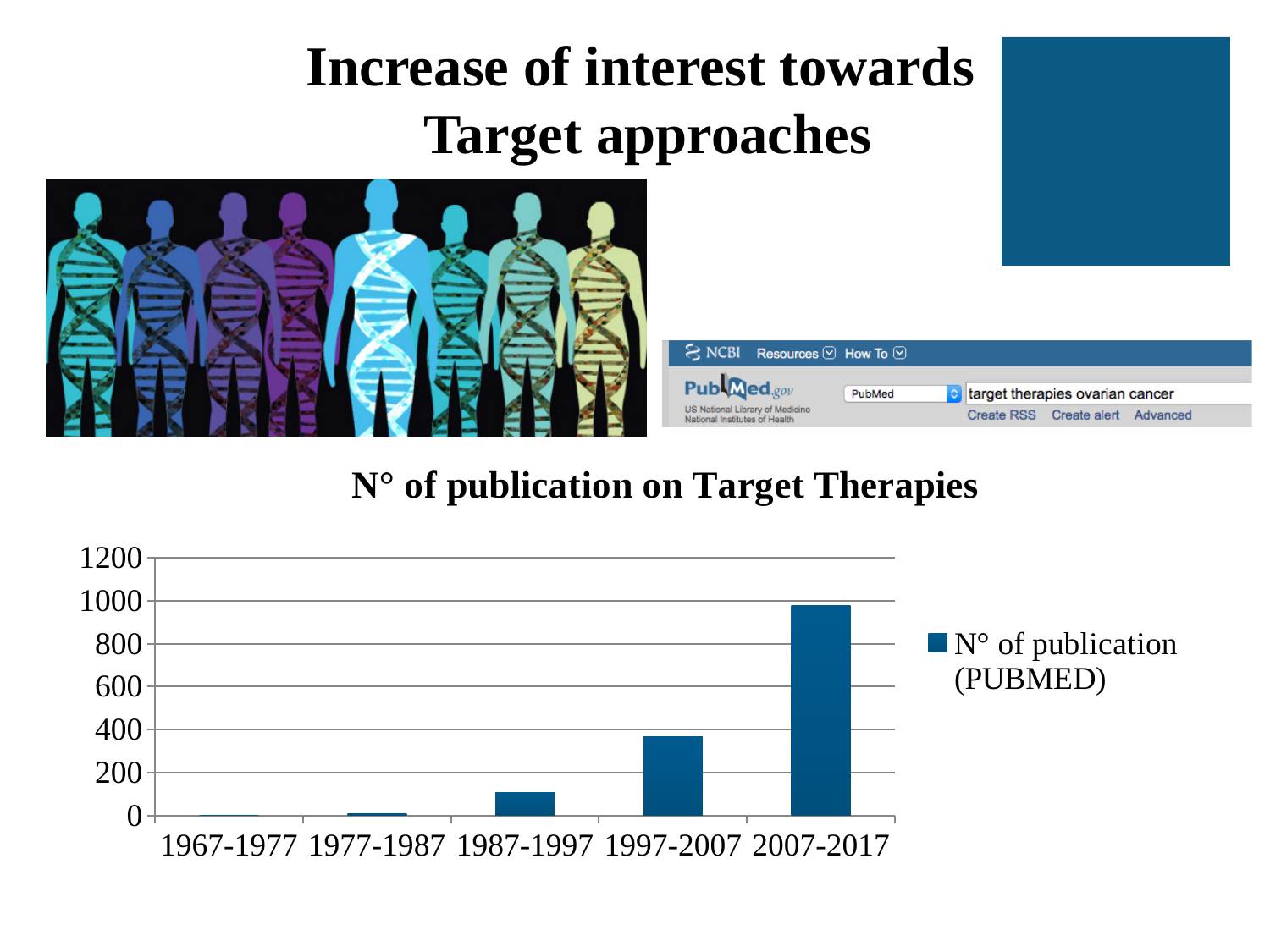
Which has more publications, 1987-1997 or 1997-2007? 1997-2007 Is the value for 1987-1997 greater or less than 200? less What series name is shown in the chart's legend? N° of publication (PUBMED) How many time periods are shown on the x axis of the chart? 5 Is the value for 1997-2007 greater or less than 400? less Which has more publications, 1997-2007 or 2007-2017? 2007-2017 What is the title of the chart? N° of publication on Target Therapies Do the values rise or fall along the x axis from 1967-1977 to 2007-2017? rise Which time period has the highest number of publications? 2007-2017 What kind of chart is shown on the slide? bar chart Is the value for 2007-2017 greater or less than 800? greater How many series does the chart's legend list? 1